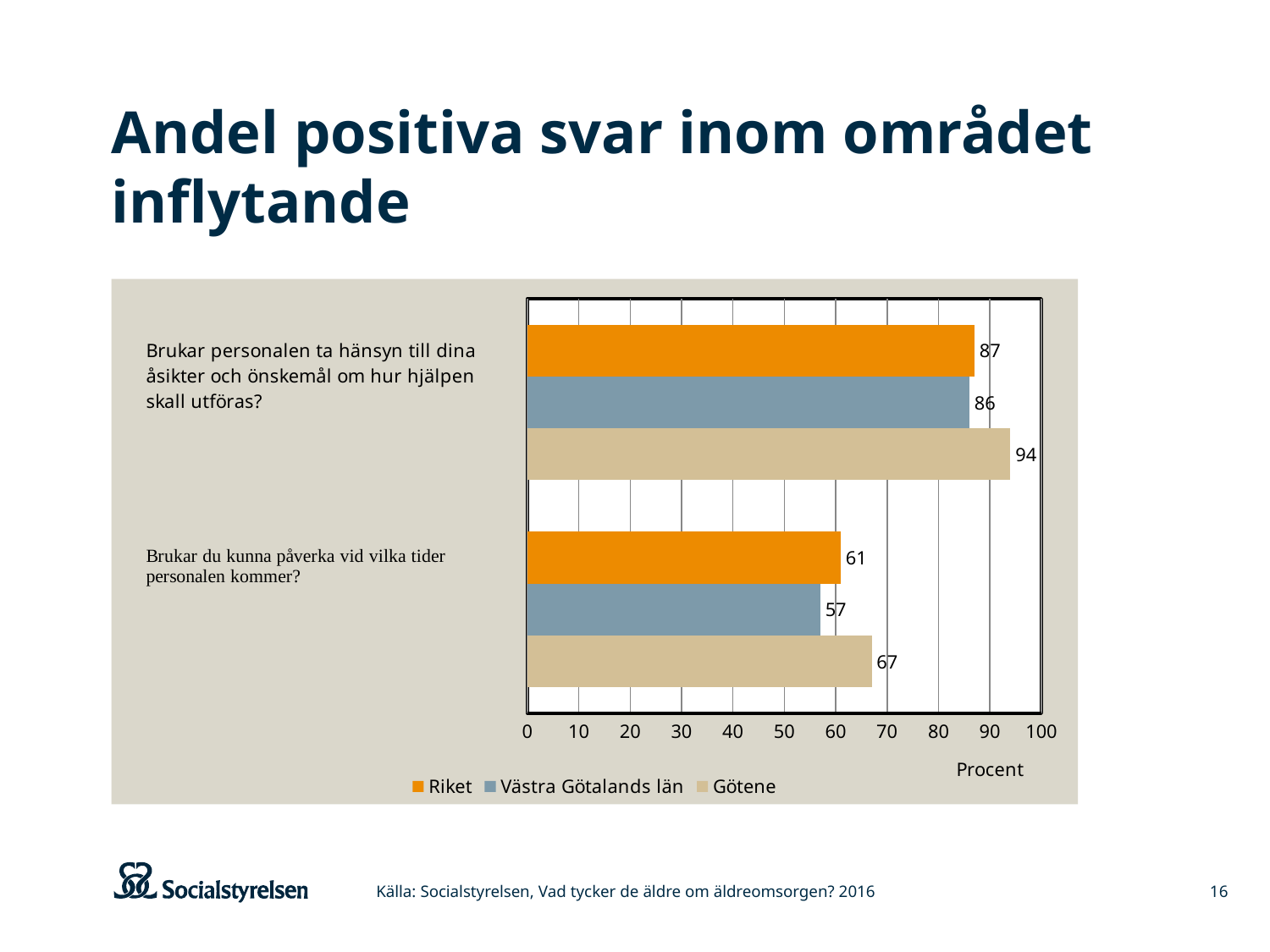
What is the value for Västra Götalands län on the question "Brukar personalen ta hänsyn till dina åsikter och önskemål om hur hjälpen skall utföras?"? 86 How many series does the legend list? 3 Which series has the lowest value on the question "Brukar du kunna påverka vid vilka tider personalen kommer?"? Västra Götalands län Which is larger: Riket or Västra Götalands län on the question "Brukar du kunna påverka vid vilka tider personalen kommer?"? Riket What is the value for Götene on the question "Brukar personalen ta hänsyn till dina åsikter och önskemål om hur hjälpen skall utföras?"? 94 What is the difference between Götene and Västra Götalands län on the question "Brukar du kunna påverka vid vilka tider personalen kommer?"? 10 How many questions (categories) are shown on the chart? 2 What unit is shown on the x axis of the chart? Procent What is the value for Riket on the question "Brukar du kunna påverka vid vilka tider personalen kommer?"? 61 What is the difference between Götene and Riket on the question "Brukar personalen ta hänsyn till dina åsikter och önskemål om hur hjälpen skall utföras?"? 7 What kind of chart is shown on the slide? Bar chart Which series has the highest value on the question "Brukar du kunna påverka vid vilka tider personalen kommer?"? Götene